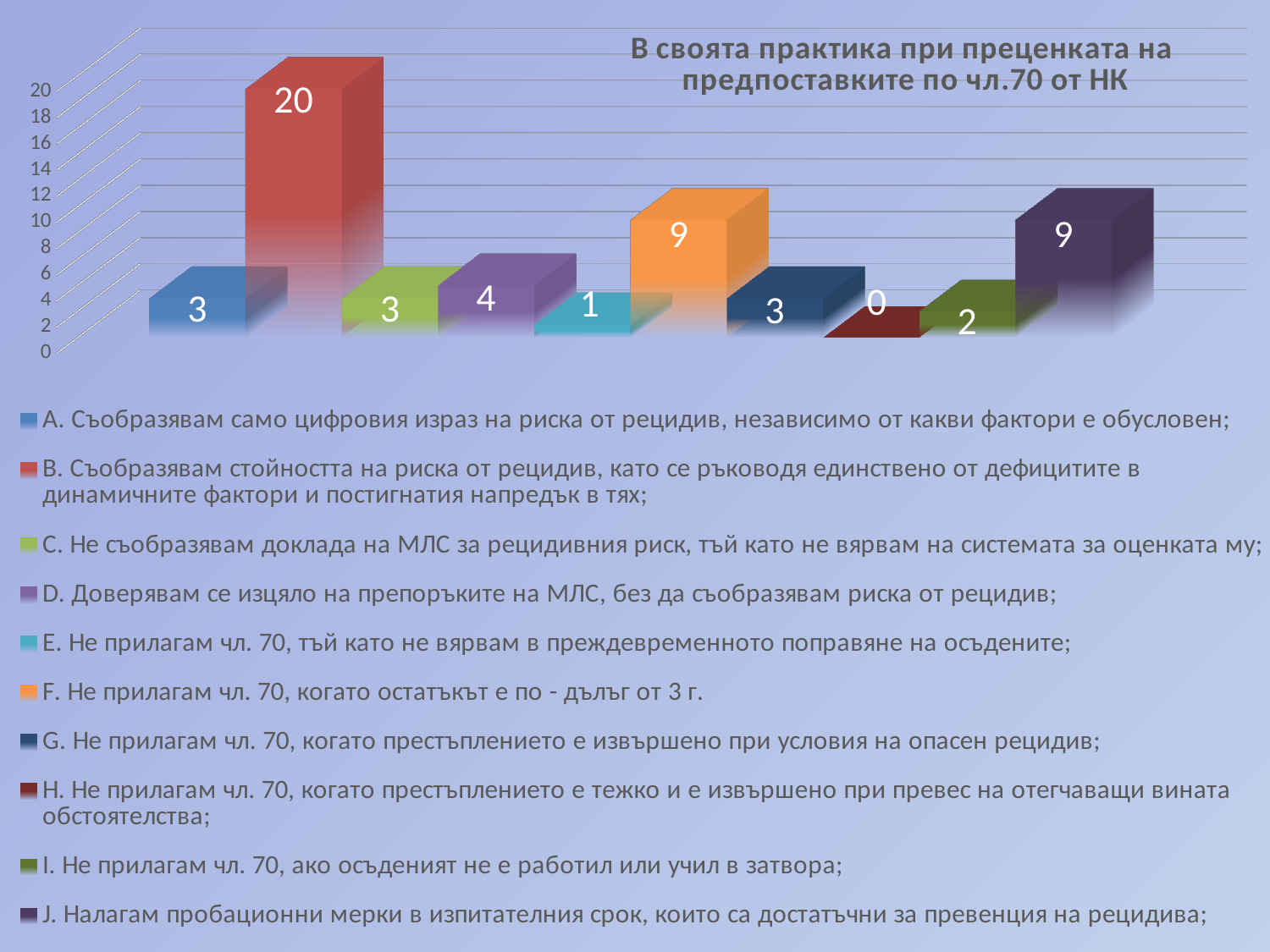
How many bars are plotted in the chart? 10 How many entries does the legend list? 10 Which has a larger value, option D or option E? D Which option has the highest value in the chart? B What kind of chart is shown on the slide? bar chart What is the title of the chart? В своята практика при преценката на предпоставките по чл.70 от НК What is the value for option B (Съобразявам стойността на риска от рецидив...)? 20 What is the value for option F (Не прилагам чл. 70, когато остатъкът е по-дълъг от 3 г.)? 9 What is the value for option E (Не прилагам чл. 70, тъй като не вярвам в преждевременното поправяне на осъдените)? 1 Which option has the lowest value in the chart? H Is the value for option B greater or less than 10? greater What is the difference between the value for option B and the value for option F? 11